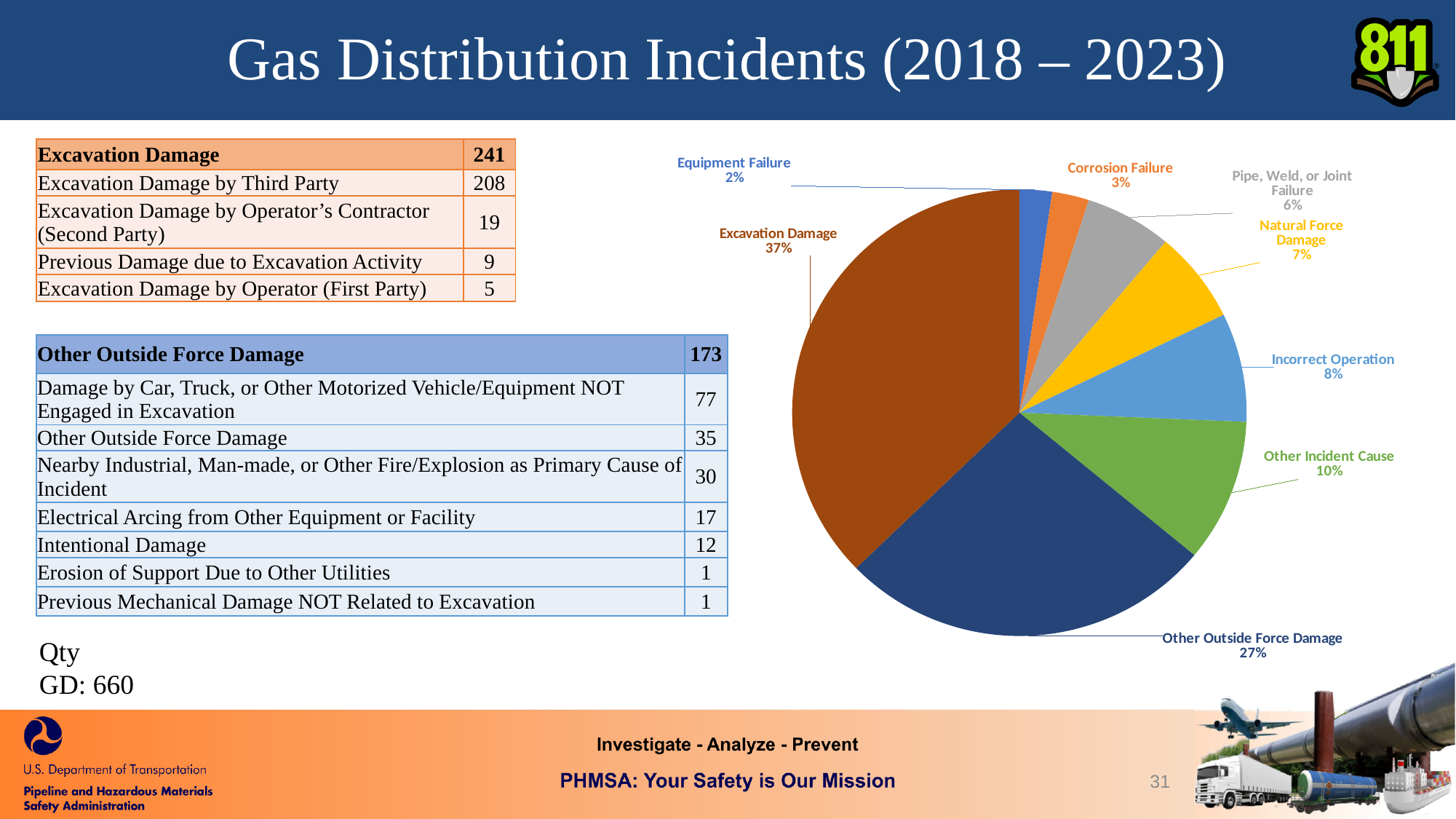
What kind of chart is shown on the slide? pie chart How many slices does the pie chart have? 8 What share of the pie does Excavation Damage represent? 37% Which category has the smallest slice of the pie? Equipment Failure What percentage is shown for Incorrect Operation? 8% What is the title of the slide containing the pie chart? Gas Distribution Incidents (2018 – 2023) What share of the pie does Other Outside Force Damage represent? 27% Which category has the largest slice of the pie? Excavation Damage What percentage is shown for Pipe, Weld, or Joint Failure? 6% Which is larger, the share for Other Incident Cause or the share for Corrosion Failure? Other Incident Cause What is the difference in percentage points between Excavation Damage and Other Outside Force Damage? 10 What percentage is shown for Natural Force Damage? 7%